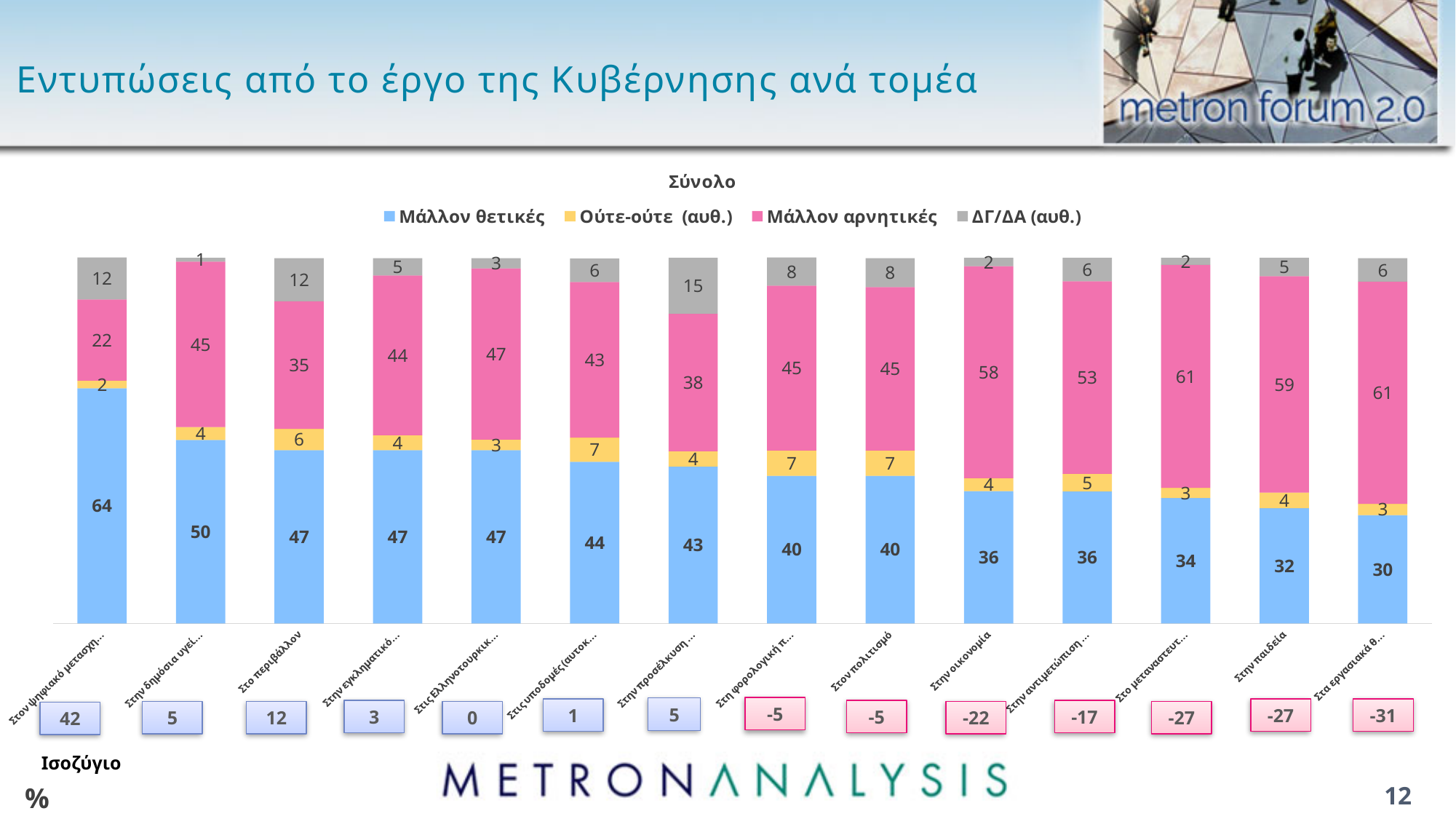
What is the value of Μάλλον θετικές for Στο περιβάλλον? 47 How many series does the legend list? 4 What is the value of ΔΓ/ΔΑ (αυθ.) for Στον πολιτισμό? 8 How many categories (bars) are plotted in the chart? 14 What is the highest value of Μάλλον θετικές shown in the chart? 64 What is the lowest value of Μάλλον θετικές shown in the chart? 30 What is the value of Ούτε-ούτε (αυθ.) for Στην παιδεία? 4 What is the value of Μάλλον αρνητικές for Στην οικονομία? 58 Do the Μάλλον θετικές values rise or fall from left to right across the chart? Fall What kind of chart is shown on the slide? Stacked bar chart For Στην οικονομία, what is the difference between Μάλλον αρνητικές and Μάλλον θετικές? 22 Which has a higher Μάλλον θετικές value, Στον πολιτισμό or Στην παιδεία? Στον πολιτισμό